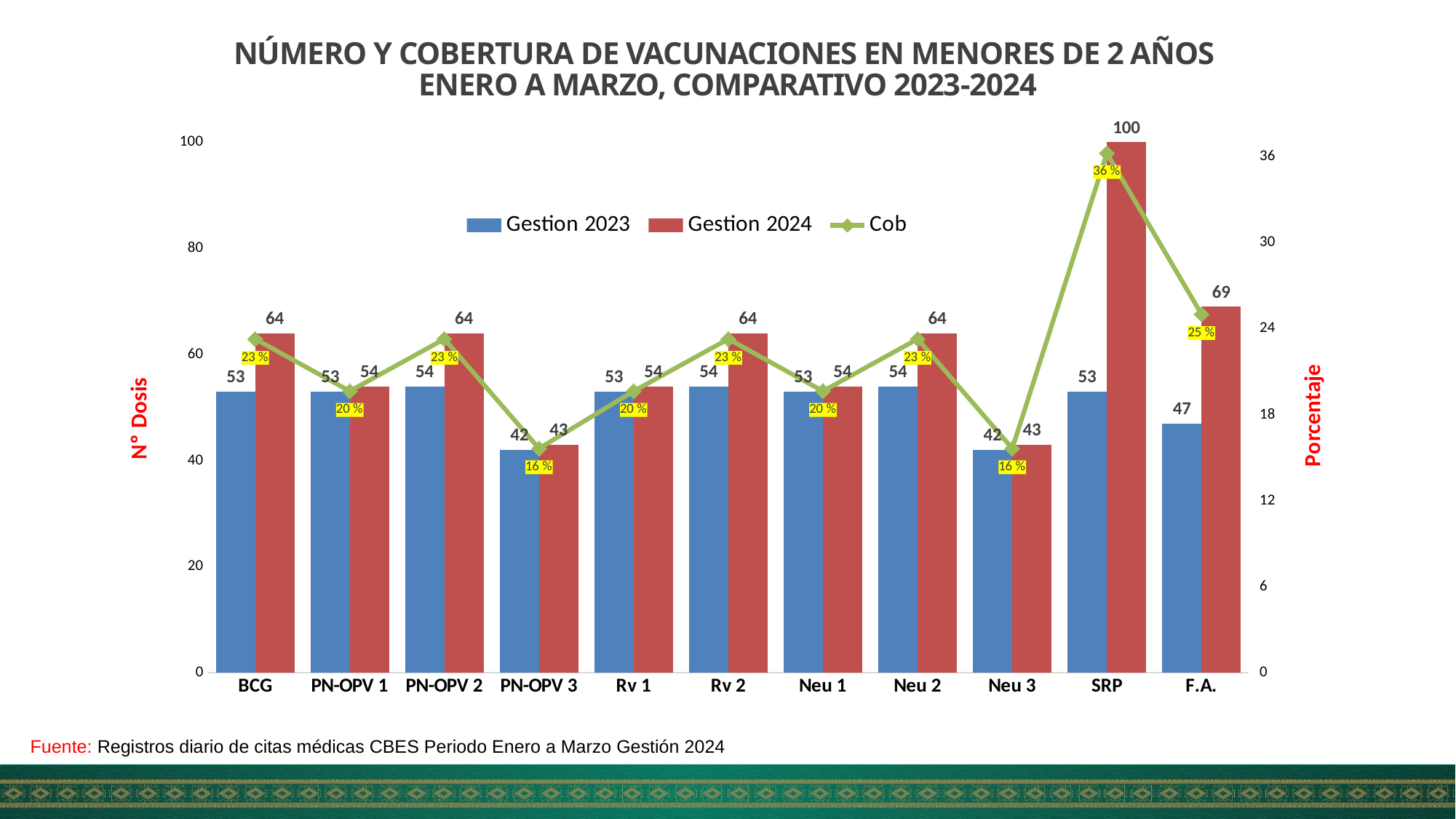
Which category has the highest Gestion 2024 value? SRP How many series does the legend list? 3 How many categories are shown on the x axis? 11 Which category has the lowest Cob value? PN-OPV 3 and Neu 3 (16 %) What kind of chart is this? Combined bar and line chart What is the Cob value for SRP? 36 % What is the Gestion 2024 value for SRP? 100 Which is larger for F.A.: the Gestion 2023 value or the Gestion 2024 value? Gestion 2024 What is the difference between the Gestion 2024 and Gestion 2023 values for SRP? 47 What is the Gestion 2023 value for F.A.? 47 What is the label of the right-hand vertical axis? Porcentaje What is the Cob value for PN-OPV 3? 16 %